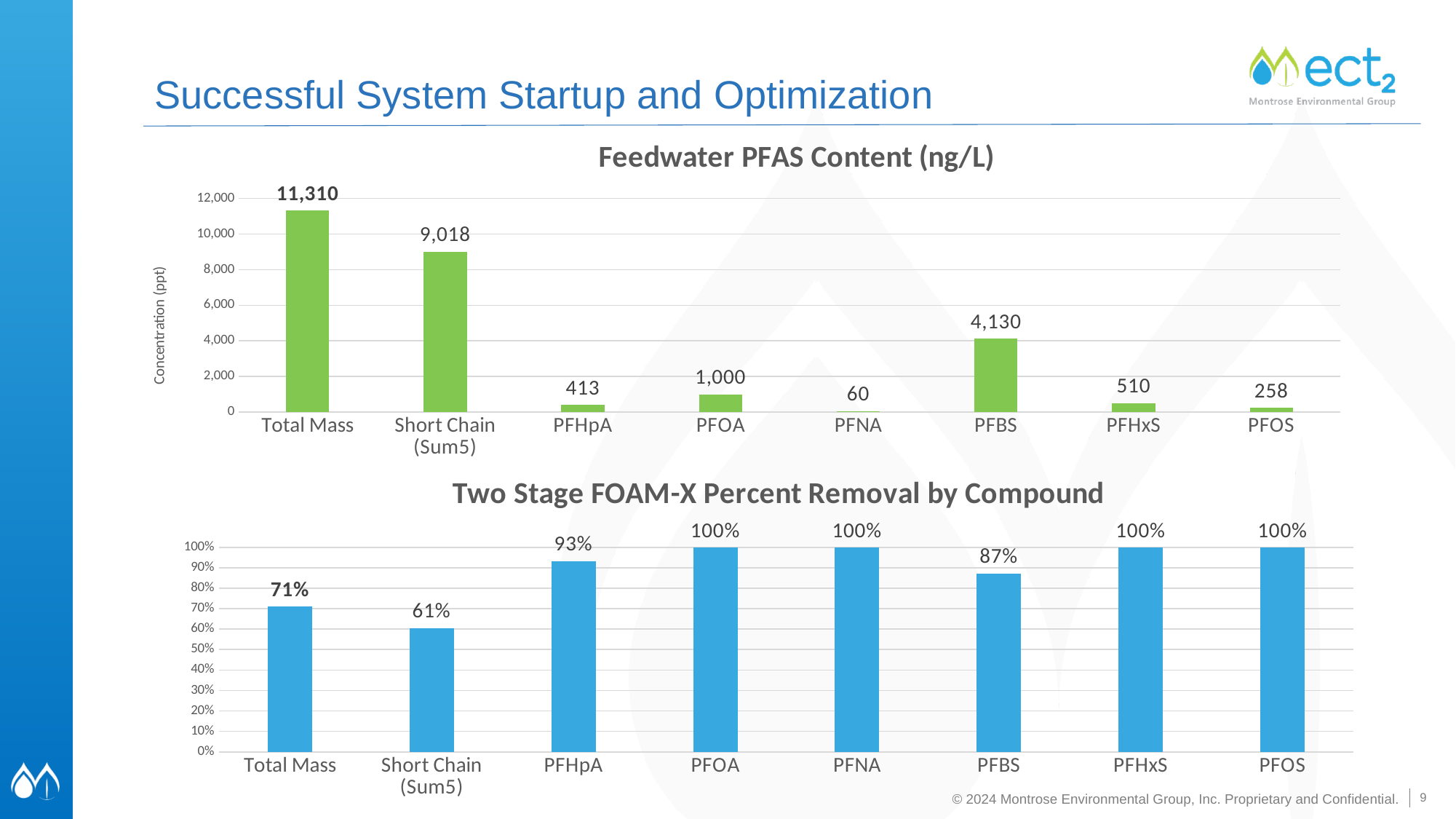
In the Two Stage FOAM-X Percent Removal by Compound chart, which category has the lowest value? Short Chain (Sum5) What kind of chart is the Two Stage FOAM-X Percent Removal by Compound chart? Bar chart In the Feedwater PFAS Content (ng/L) chart, what is the difference between the PFOA and PFHxS values? 490 In the Feedwater PFAS Content (ng/L) chart, what is the value for PFBS? 4,130 In the Feedwater PFAS Content (ng/L) chart, how many categories are shown on the x axis? 8 In the Feedwater PFAS Content (ng/L) chart, what is the value for Short Chain (Sum5)? 9,018 In the Two Stage FOAM-X Percent Removal by Compound chart, what is the difference between the PFHpA and Short Chain (Sum5) values? 32% In the Two Stage FOAM-X Percent Removal by Compound chart, what is the value for PFBS? 87% In the Two Stage FOAM-X Percent Removal by Compound chart, what is the value for Total Mass? 71% In the Feedwater PFAS Content (ng/L) chart, which is larger, PFHpA or PFOS? PFHpA In the Feedwater PFAS Content (ng/L) chart, which category has the lowest value? PFNA In the Two Stage FOAM-X Percent Removal by Compound chart, how many categories reach 100%? 4